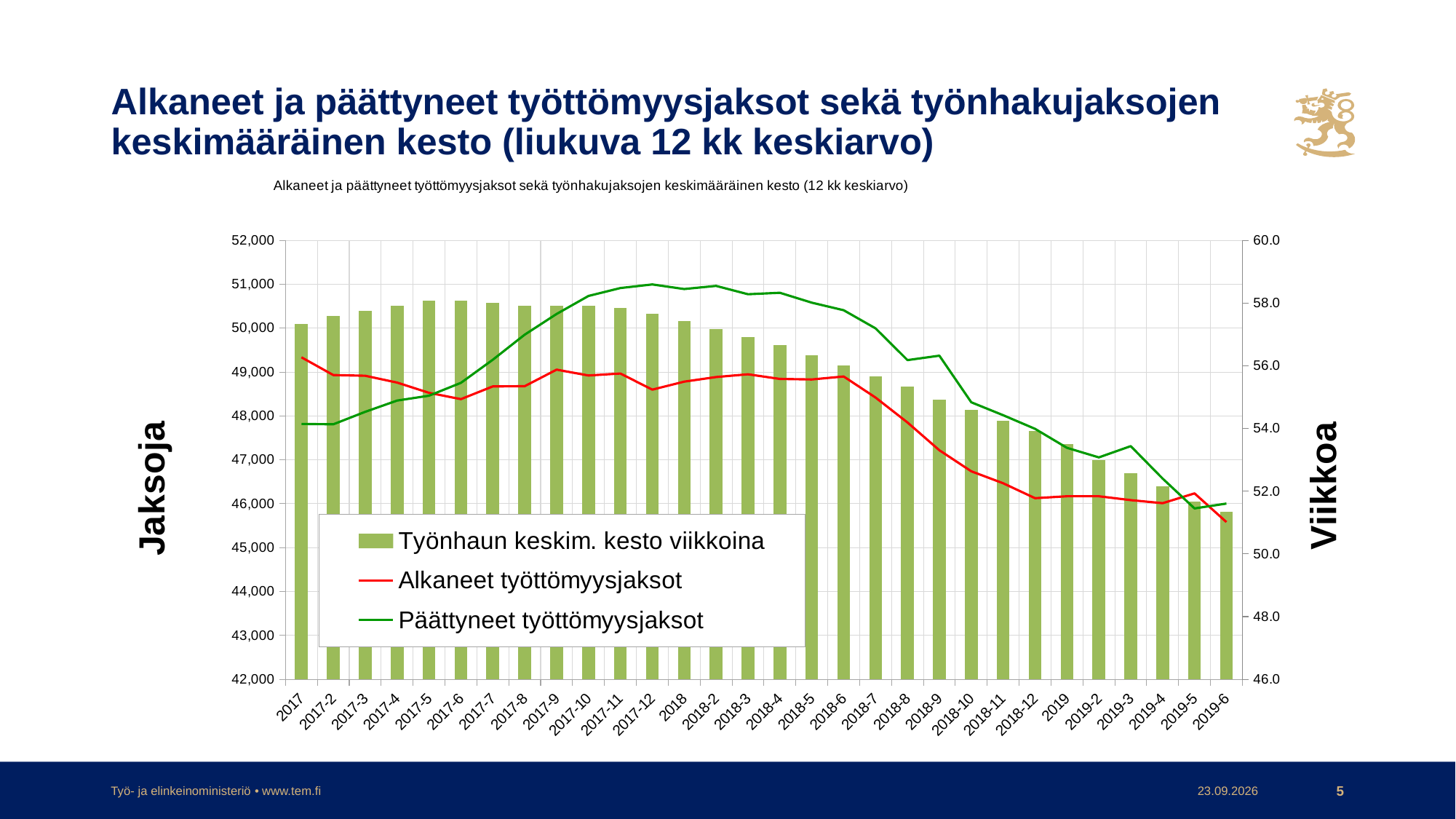
What is the title of the right-hand vertical axis? Viikkoa Is the value of the Alkaneet työttömyysjaksot line for 2017 greater or less than 49,000? greater Does the Alkaneet työttömyysjaksot line overall rise or fall from 2017 to 2019-6? fall What kind of chart is this? Combination bar and line chart How many categories are shown on the x axis? 30 Is the value of the Työnhaun keskim. kesto viikkoina bar for 2017 greater or less than 56.0 on the right axis? greater Is the value of the Päättyneet työttömyysjaksot line for 2017-12 greater or less than 50,000? greater How many series does the legend list? 3 Which category has the lowest Työnhaun keskim. kesto viikkoina bar? 2019-6 Which series is drawn as bars? Työnhaun keskim. kesto viikkoina At 2017-12, which line is higher: Alkaneet työttömyysjaksot or Päättyneet työttömyysjaksot? Päättyneet työttömyysjaksot